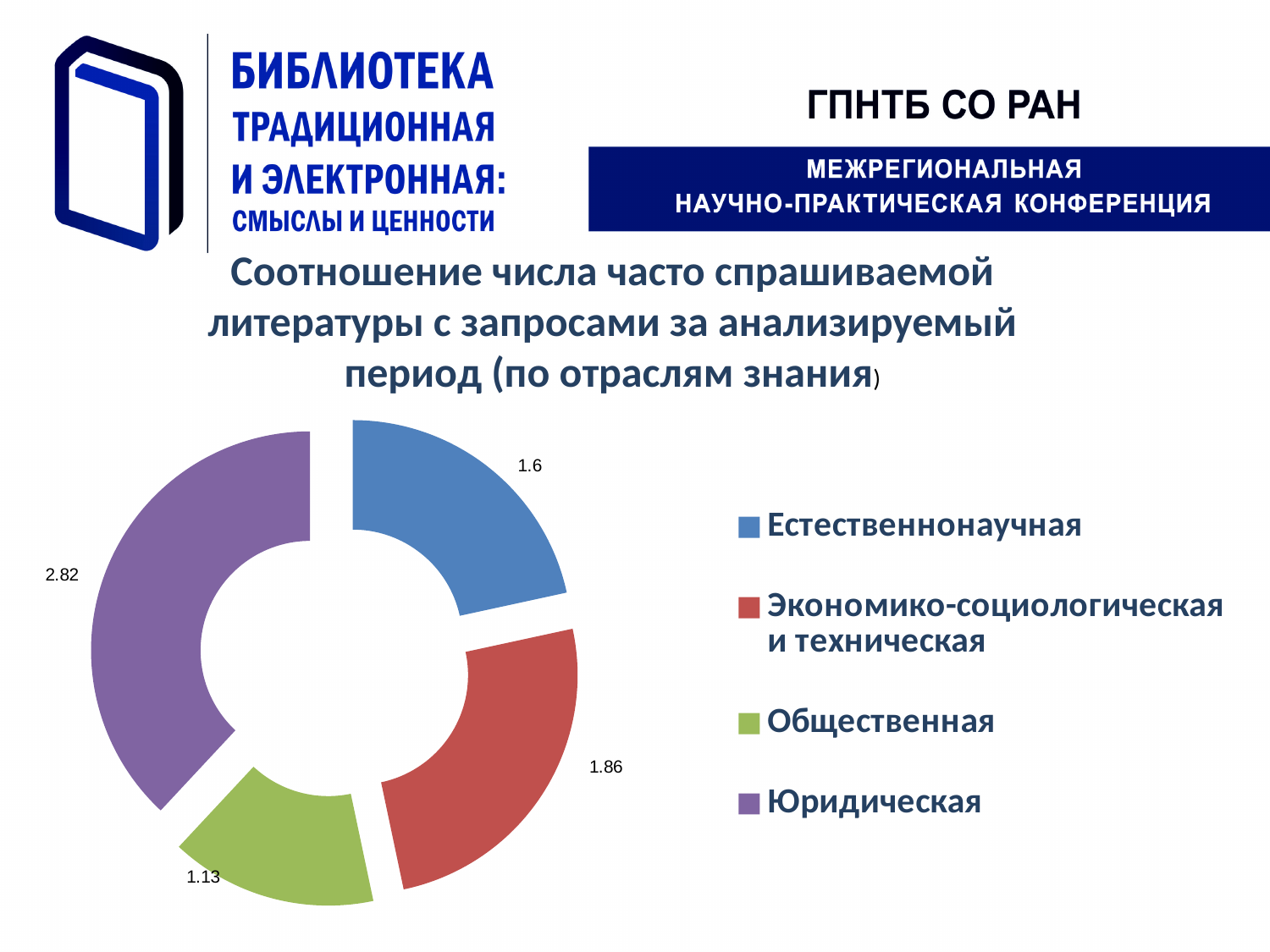
Which category has the lowest value? Общественная What is the value for Естественнонаучная? 1.6 Which is larger, the value for Юридическая or the value for Экономико-социологическая и техническая? Юридическая What type of chart is shown on the slide? Doughnut chart What colour is the segment for Общественная? Green What is the value for Экономико-социологическая и техническая? 1.86 What is the difference between the values for Экономико-социологическая и техническая and Естественнонаучная? 0.26 What is the difference between the values for Юридическая and Общественная? 1.69 Which category has the highest value? Юридическая How many categories does the chart show? 4 What is the value for Юридическая? 2.82 What is the value for Общественная? 1.13